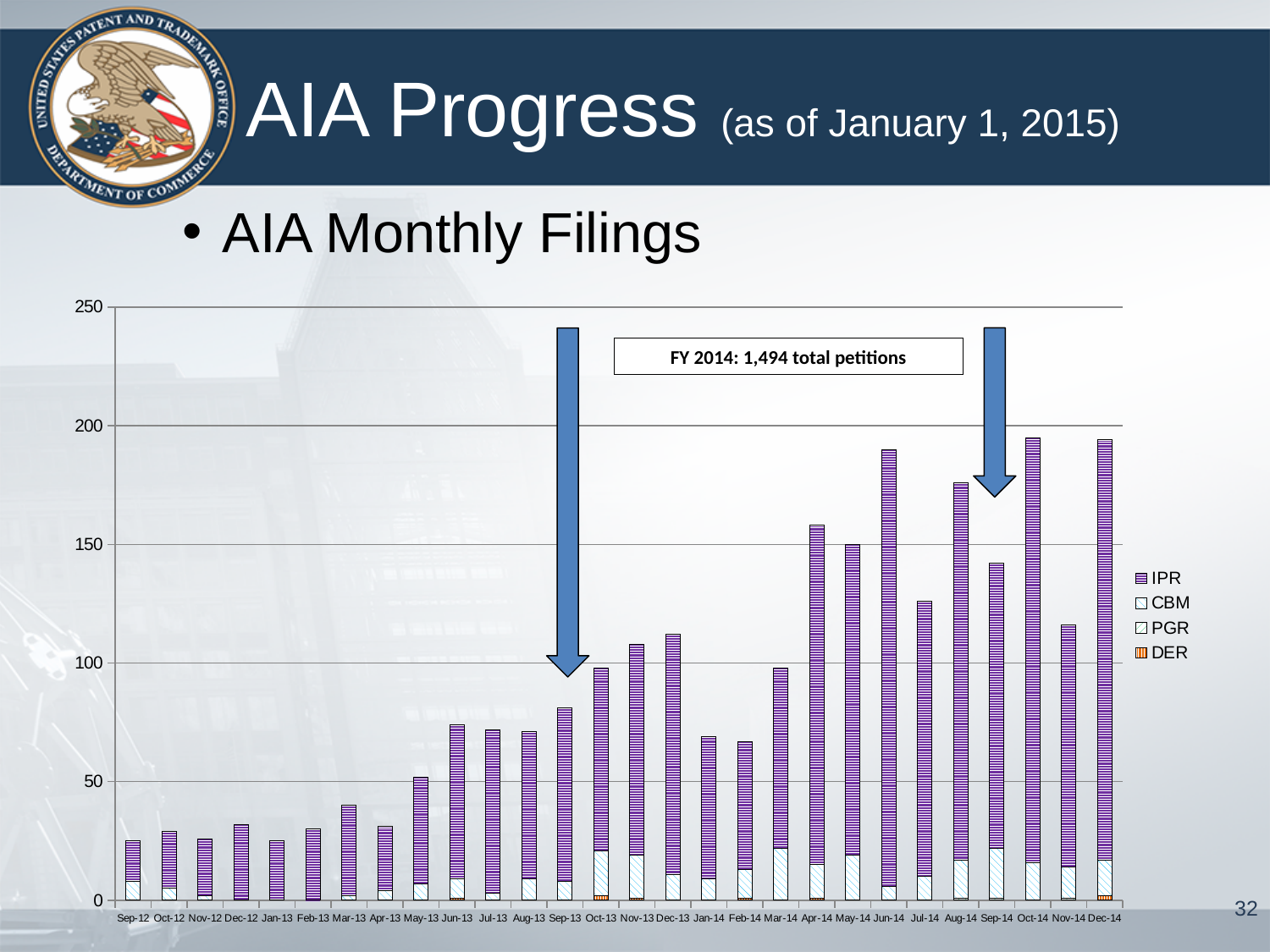
How many series does the legend list? 4 Which month has the larger total, Dec-13 or Jan-14? Dec-13 Which month has the larger total, Jun-14 or Jul-14? Jun-14 How many months are plotted along the x axis? 28 What kind of chart is shown on the slide? stacked bar chart Is the total value for Nov-14 greater or less than 100? greater Overall, do the monthly filing totals rise or fall from Sep-12 to Dec-14? rise Is the total value for Jun-14 greater or less than 150? greater Is the total value for Mar-13 greater or less than 50? less What total number of petitions does the annotation box give for FY 2014? 1,494